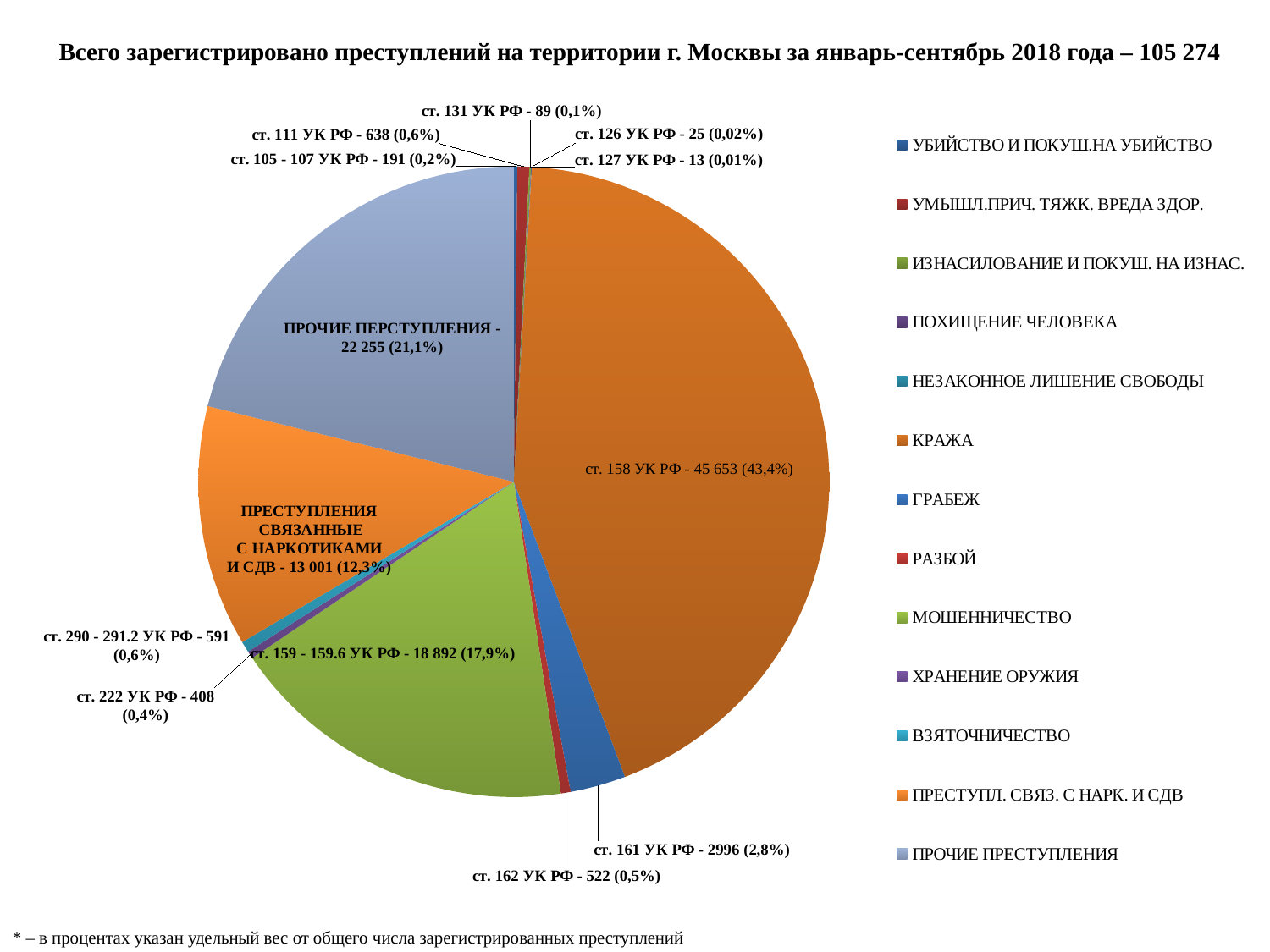
What total number of registered crimes is stated in the chart title? 105 274 What share of the pie does ст. 159 - 159.6 УК РФ (МОШЕННИЧЕСТВО) represent? 17,9% What is the difference between the values for ст. 158 УК РФ and ПРОЧИЕ ПРЕСТУПЛЕНИЯ? 23 398 Which category has the largest slice of the pie chart? ст. 158 УК РФ (КРАЖА) Which is larger: the value for ст. 161 УК РФ or the value for ст. 162 УК РФ? ст. 161 УК РФ Which category has the smallest slice of the pie chart? ст. 127 УК РФ How many entries does the legend of the pie chart list? 13 What is the value shown for ст. 161 УК РФ on the pie chart? 2996 (2,8%) What is the value shown for ПРОЧИЕ ПРЕСТУПЛЕНИЯ on the pie chart? 22 255 (21,1%) What is the value shown for ст. 127 УК РФ on the pie chart? 13 (0,01%) What is the value shown for ст. 158 УК РФ (КРАЖА) on the pie chart? 45 653 (43,4%) What kind of chart is shown on the slide? pie chart